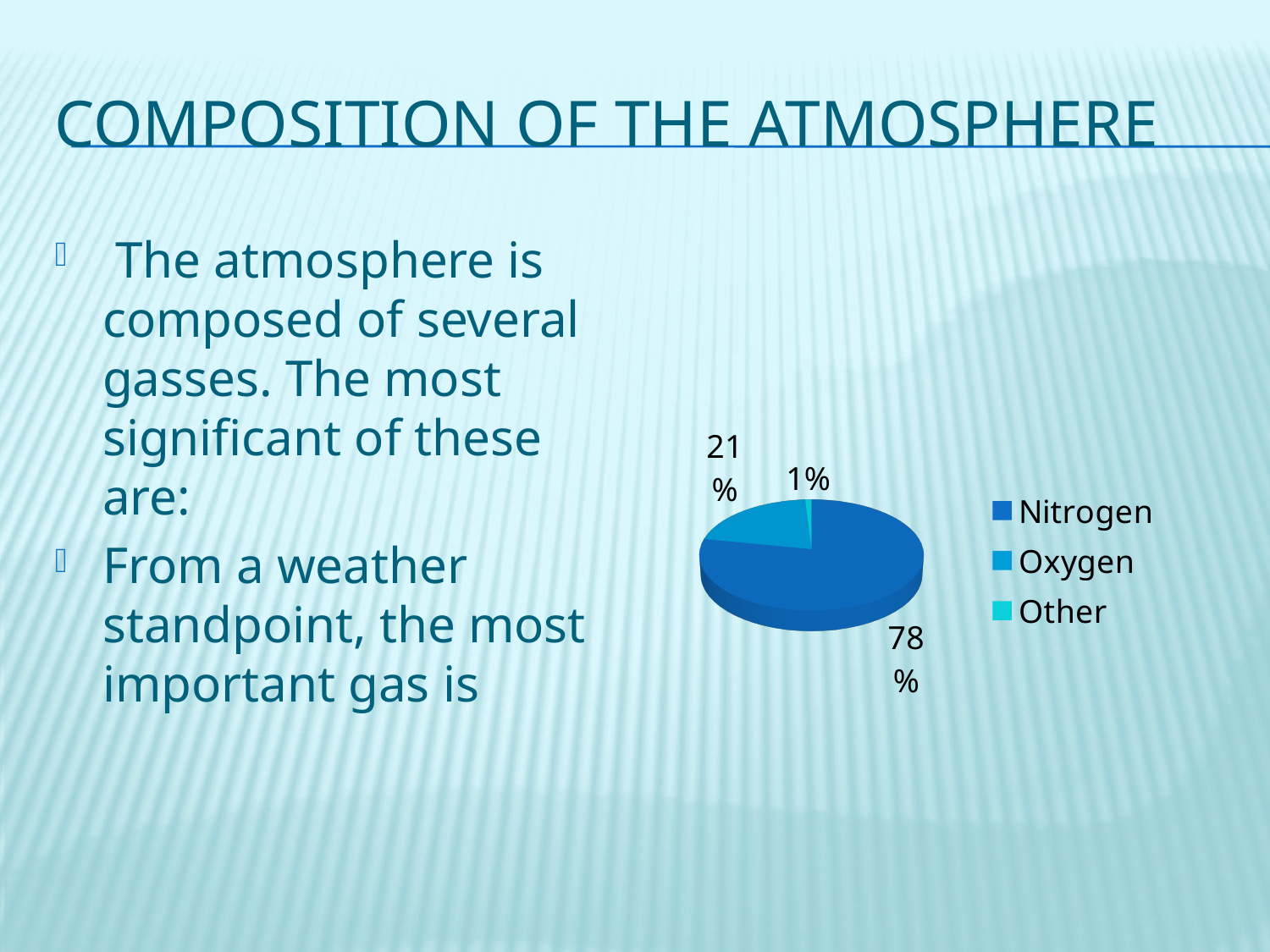
How many slices does the pie chart have? 3 Which legend entry is listed first? Nitrogen Which slice of the pie is the largest? Nitrogen How many entries does the legend list? 3 What is the difference between the Nitrogen and Oxygen shares? 57% What share of the pie does Nitrogen represent? 78% Which slice of the pie is the smallest? Other What is the difference between the Oxygen and Other shares? 20% Which is larger, the Oxygen slice or the Other slice? Oxygen What share of the pie does Oxygen represent? 21% What share of the pie does Other represent? 1% What kind of chart is shown on the slide? pie chart